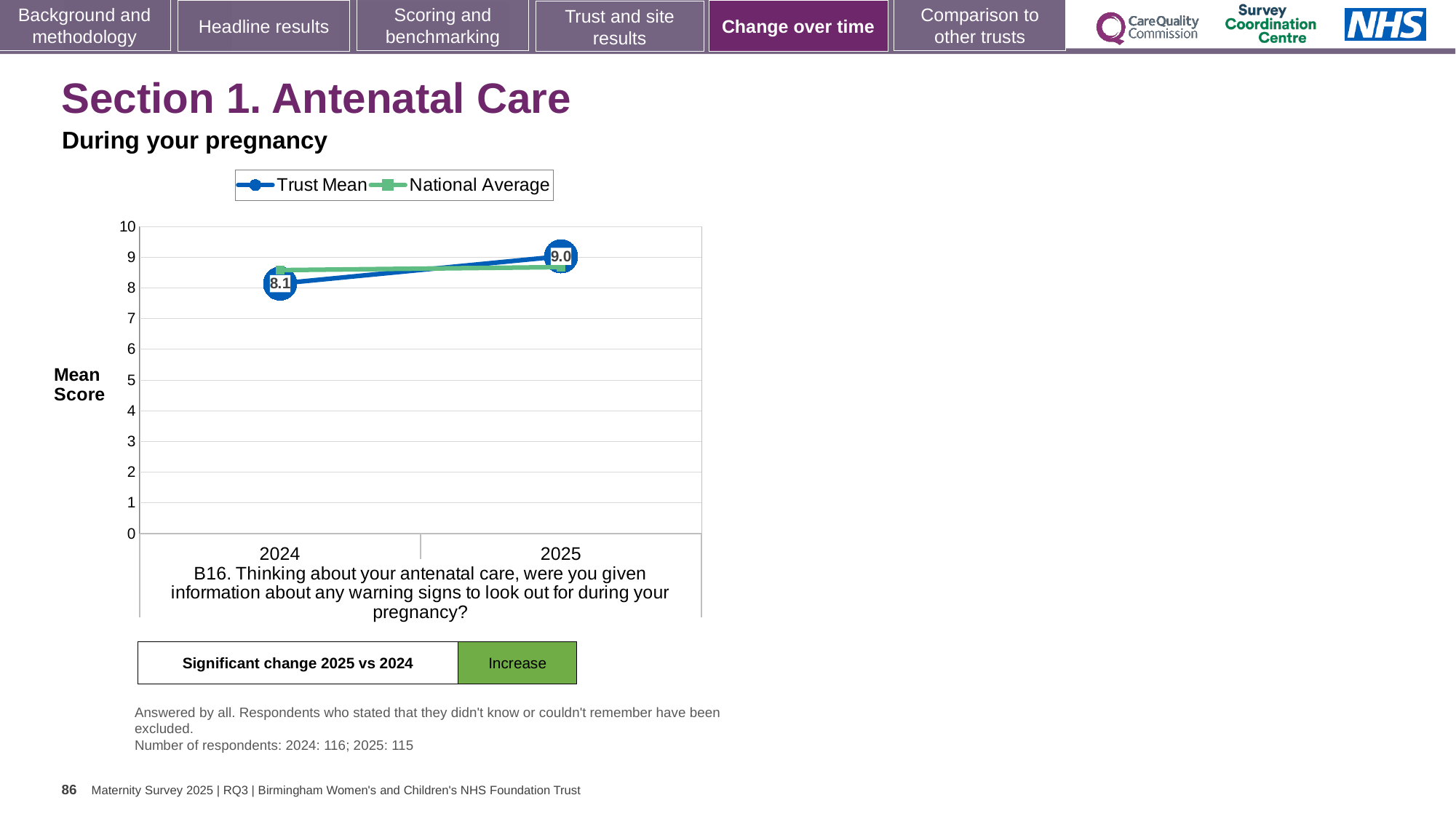
What kind of chart is shown on the slide? line chart How many years are plotted on the x axis? 2 Does the Trust Mean rise or fall from 2024 to 2025? rise Is the National Average value for 2025 greater or less than 9? less What is the Trust Mean score for 2025? 9.0 What is the Trust Mean score for 2024? 8.1 Is the National Average value for 2024 greater or less than 8? greater How many series does the legend list? 2 By how much did the Trust Mean score change from 2024 to 2025? 0.9 What does the 'Significant change 2025 vs 2024' box below the chart say? Increase In 2024, which is higher, the Trust Mean or the National Average? National Average Which year has the higher Trust Mean score, 2024 or 2025? 2025